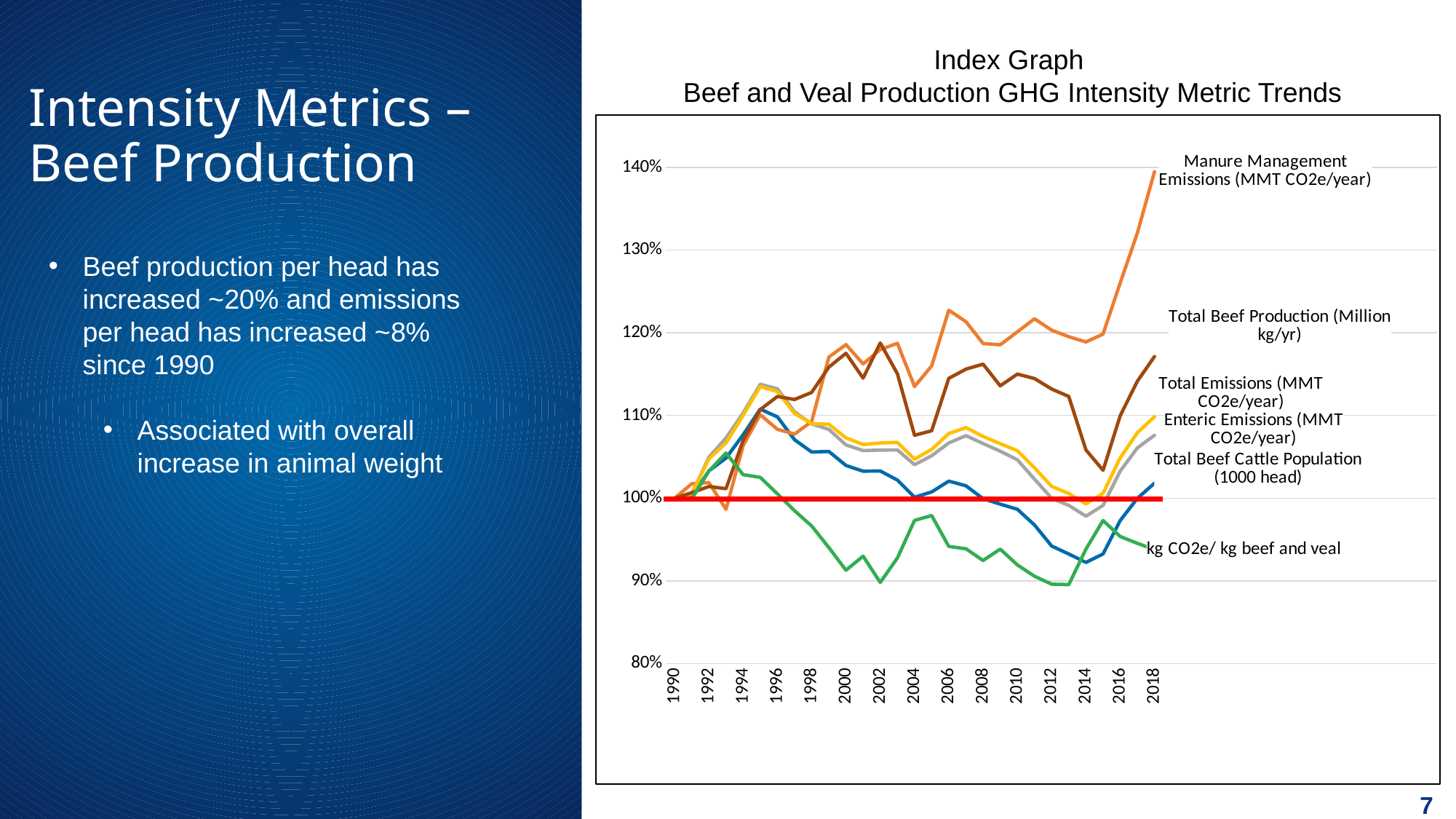
What type of chart is shown on the slide? Line chart Does the kg CO2e/ kg beef and veal series rise or fall between 1993 and 2002? Fall How many data series are labelled on the chart? 6 Does the Manure Management Emissions series rise or fall between 2014 and 2018? Rise Is the value for Total Beef Production in 2018 greater or less than 110%? greater Which series has the highest value in 2018? Manure Management Emissions (MMT CO2e/year) Is the value for kg CO2e/ kg beef and veal in 2018 greater or less than 100%? less At what index value does the horizontal red reference line sit? 100% Which series has the lowest value in 2018? kg CO2e/ kg beef and veal What is the title of the chart on the slide? Index Graph Beef and Veal Production GHG Intensity Metric Trends In 2018, which is larger: Total Beef Production or Total Beef Cattle Population? Total Beef Production Is the value for Manure Management Emissions in 2018 greater or less than 130%? greater